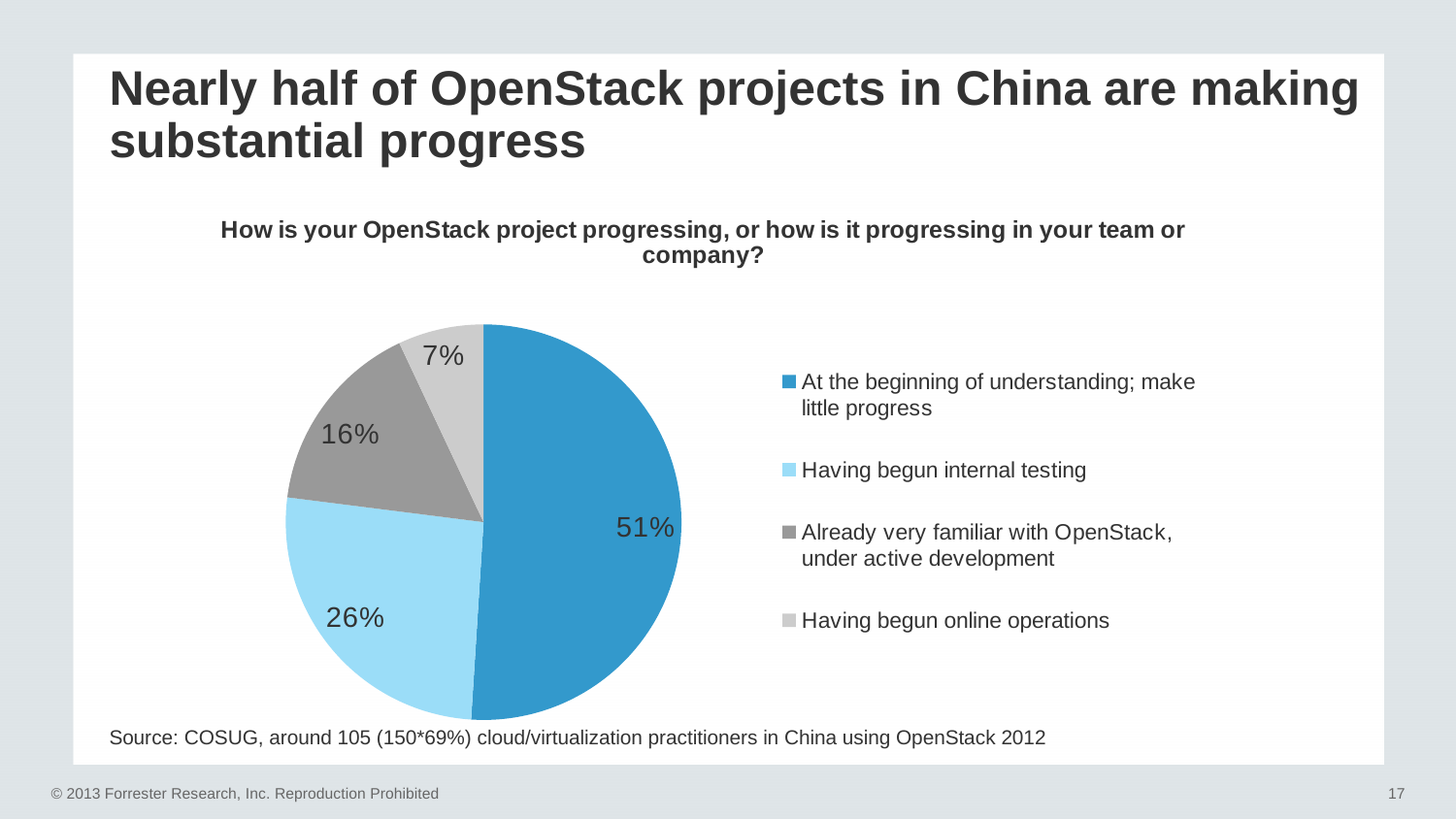
What question is the chart based on, as shown in its title? How is your OpenStack project progressing, or how is it progressing in your team or company? What percentage of respondents are already very familiar with OpenStack and under active development? 16% What percentage of respondents have begun online operations? 7% What is the combined share of 'Already very familiar with OpenStack, under active development' and 'Having begun online operations'? 23% What is the difference in percentage points between 'Having begun internal testing' and 'Having begun online operations'? 19 Which category has the largest share of the pie? At the beginning of understanding; make little progress How many categories does the pie chart show? 4 What kind of chart is shown on the slide? Pie chart What percentage of respondents are at the beginning of understanding and making little progress? 51% What share of respondents have begun internal testing? 26% Which category has the smallest share of the pie? Having begun online operations Which is larger: the share for 'Having begun internal testing' or the share for 'Already very familiar with OpenStack, under active development'? Having begun internal testing